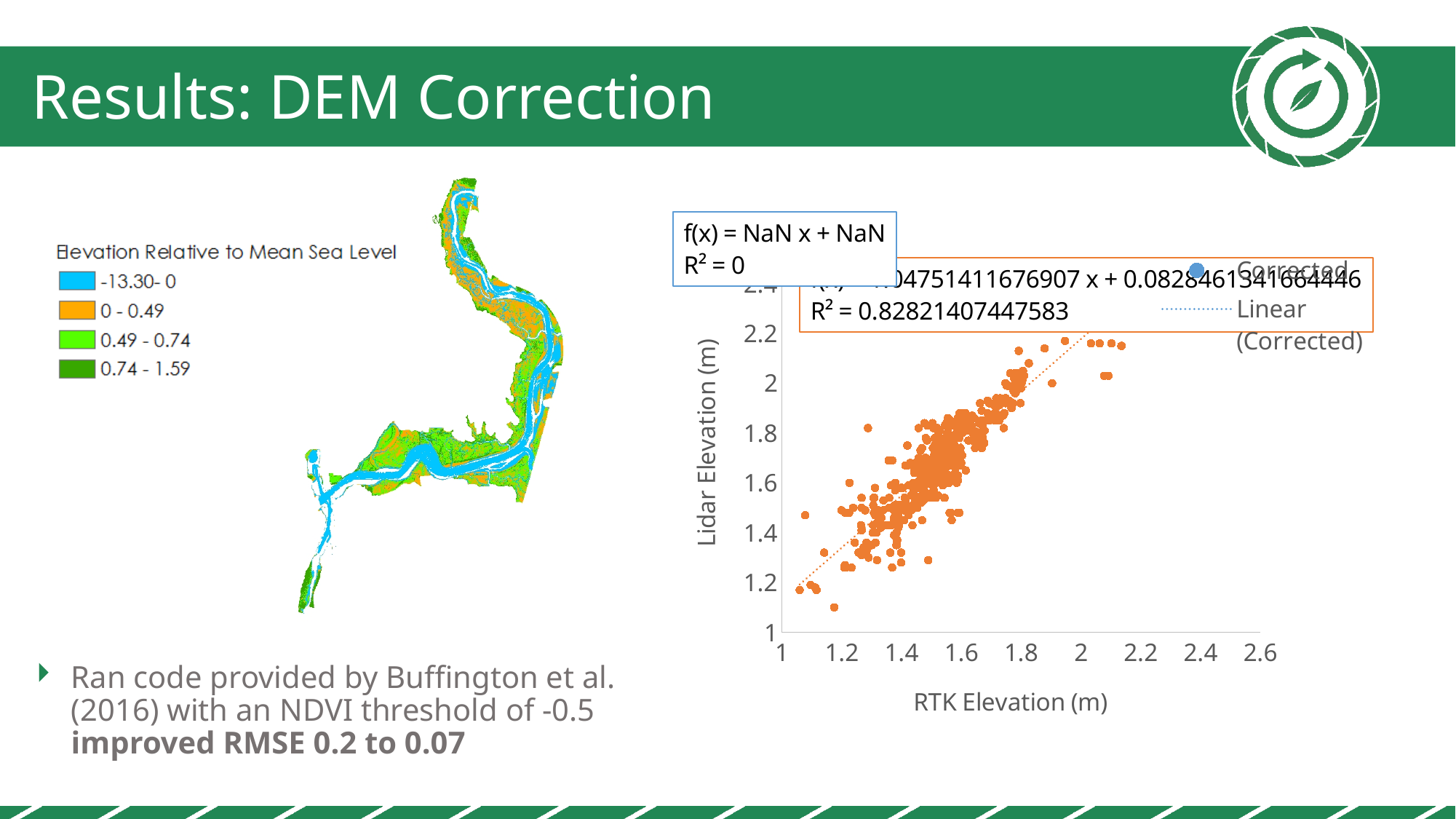
In the scatter chart, what is the largest tick value shown on the x axis? 2.6 In the scatter chart, what is the label of the x axis? RTK Elevation (m) In the scatter chart, what is the label of the y axis? Lidar Elevation (m) In the scatter chart, is the highest plotted Lidar Elevation value greater or less than 2? greater In the scatter chart, what is the largest tick value shown on the y axis? 2.4 What kind of chart is shown on the right side of the slide? scatter chart How many entries does the legend of the scatter chart list? 2 In the scatter chart, what R² value is shown for the linear trendline of the Corrected series? 0.82821407447583 In the scatter chart, is the lowest plotted Lidar Elevation value greater or less than 1.2? less In the scatter chart, do the Lidar Elevation values generally rise or fall as RTK Elevation increases? rise